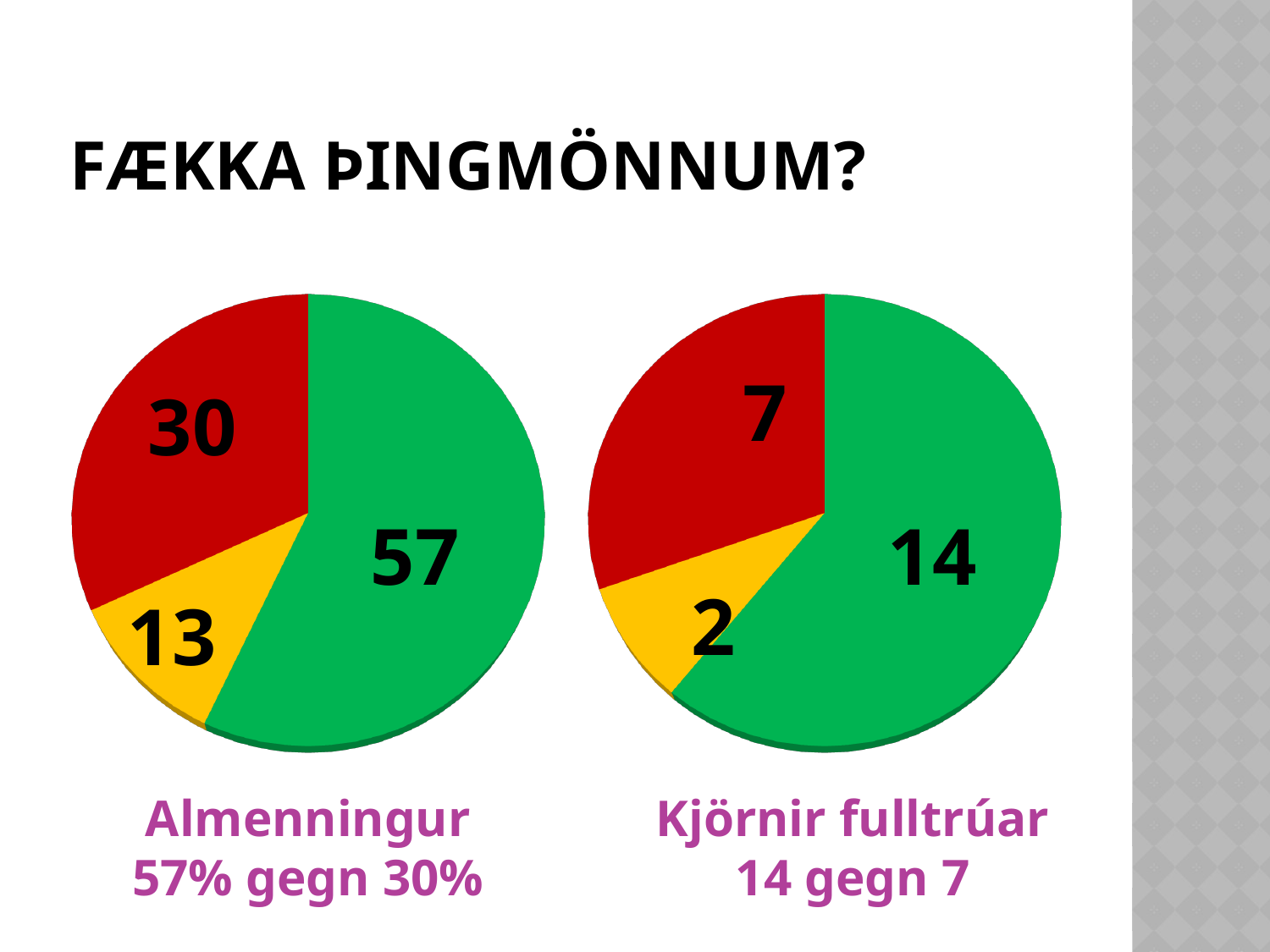
What kind of chart is used for Almenningur? pie chart On the Kjörnir fulltrúar pie chart, what is the difference between the green slice and the red slice? 7 What is the total of all slices in the Kjörnir fulltrúar pie chart? 23 On the Almenningur pie chart, what value is shown on the yellow slice? 13 On the Almenningur pie chart, what is the difference between the green slice and the red slice? 27 On the Kjörnir fulltrúar pie chart, which colour slice has the smallest value? yellow On the Kjörnir fulltrúar pie chart, what value is shown on the red slice? 7 On the Almenningur pie chart, what value is shown on the green slice? 57 On the Almenningur pie chart, which colour slice has the largest value? green On the Almenningur pie chart, which is larger, the red slice or the yellow slice? red On the Kjörnir fulltrúar pie chart, what value is shown on the yellow slice? 2 How many slices does the Kjörnir fulltrúar pie chart have? 3